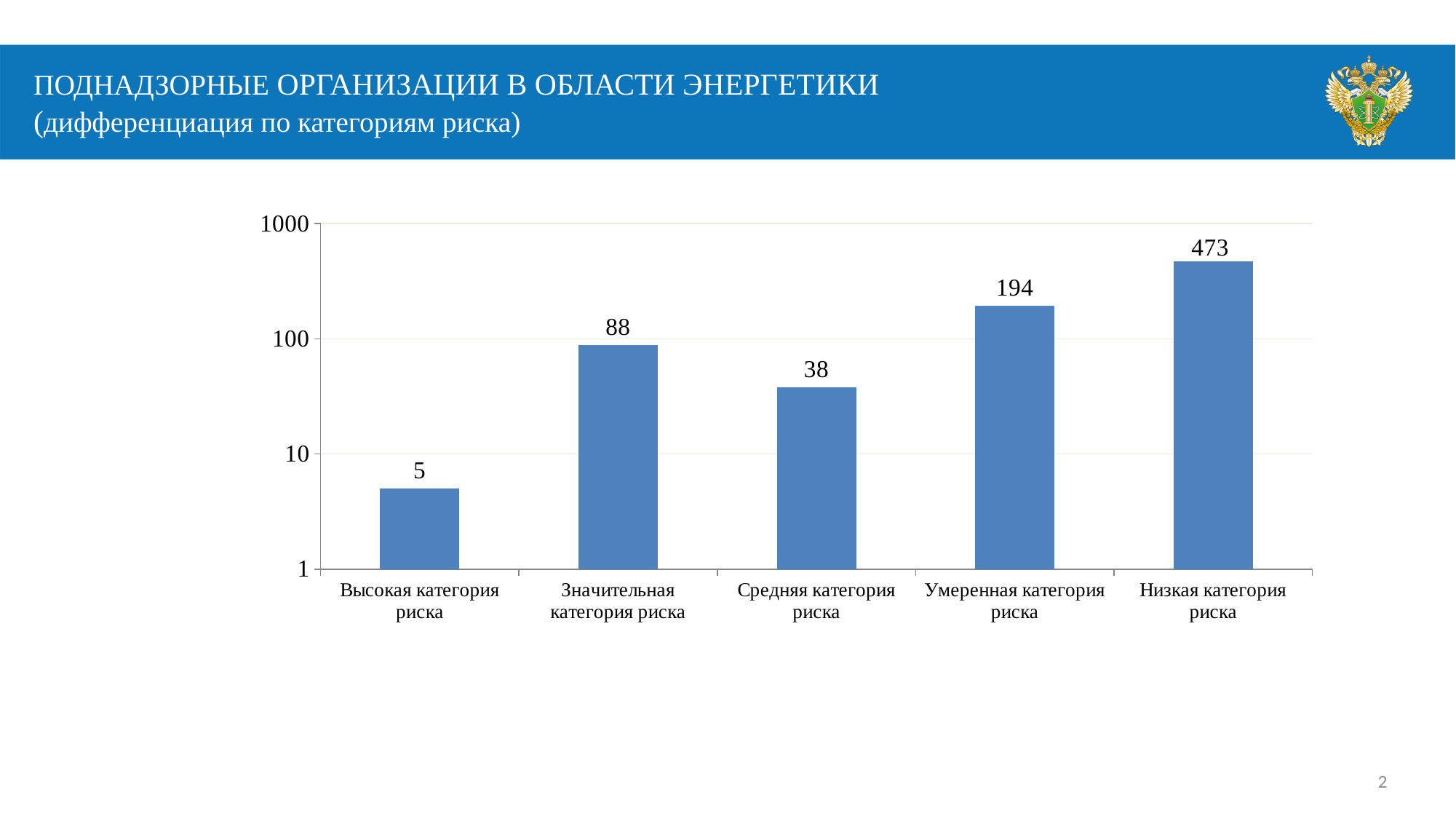
Which is larger, the value for Значительная категория риска or Средняя категория риска? Значительная категория риска What is the value for Средняя категория риска? 38 What kind of chart is shown on the slide? Bar chart What is the difference between the values for Низкая категория риска and Умеренная категория риска? 279 What is the value for Низкая категория риска? 473 Which category has the lowest value? Высокая категория риска Which category has the highest value? Низкая категория риска What is the value for Умеренная категория риска? 194 What is the value for Значительная категория риска? 88 What is the highest tick value shown on the vertical axis? 1000 What is the value for Высокая категория риска? 5 How many categories are shown on the chart? 5